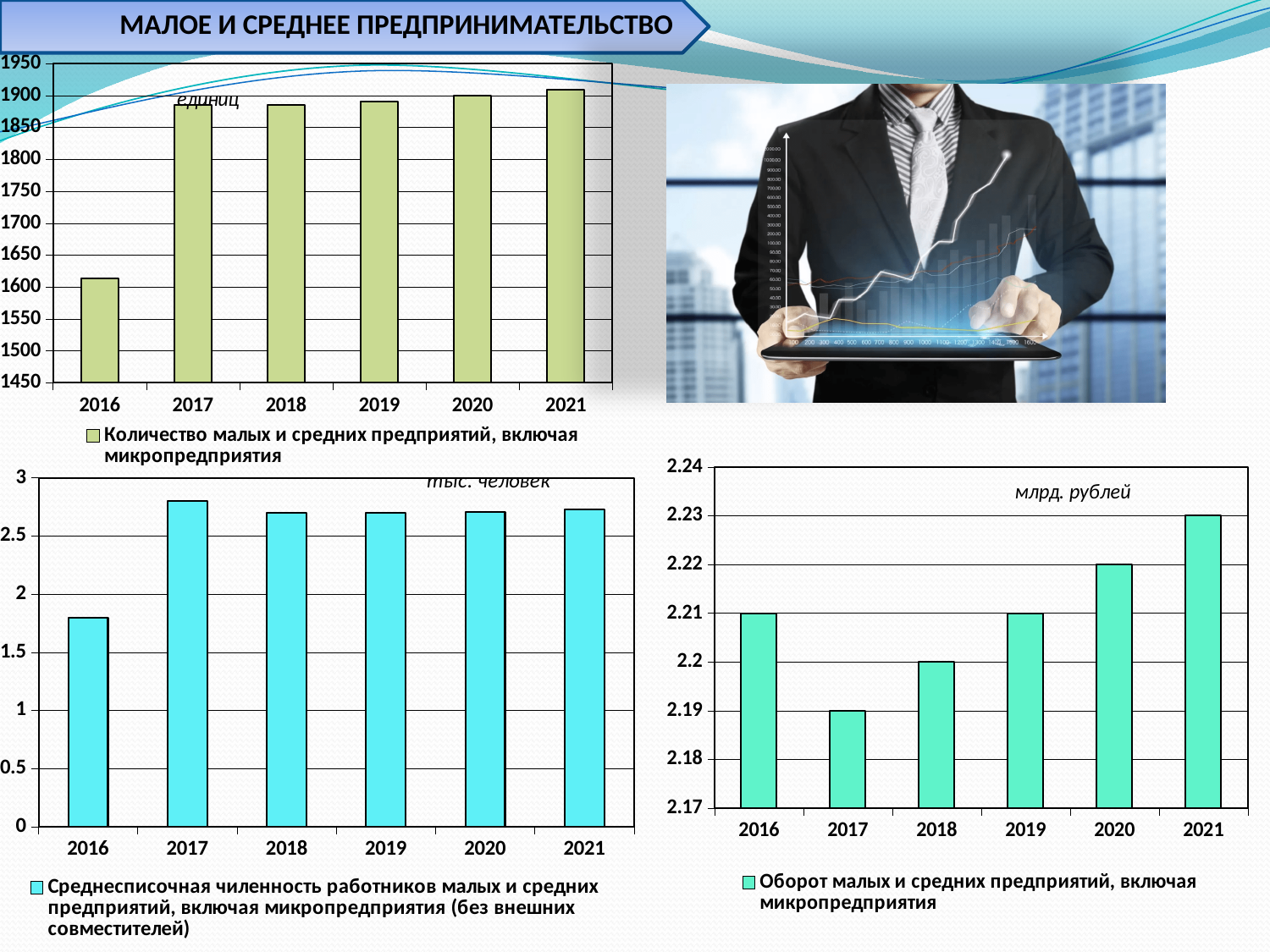
On the bottom-right chart (Оборот малых и средних предприятий), which year has the highest value? 2021 How many years are shown on the bottom-right chart (Оборот малых и средних предприятий)? 6 On the bottom-left chart (Среднесписочная численность работников), is the value for 2016 greater or less than 2? less On the top-left chart (Количество малых и средних предприятий), which year has the lowest value? 2016 On the bottom-right chart (Оборот малых и средних предприятий), what is the value for 2021? 2.23 On the bottom-right chart (Оборот малых и средних предприятий), which year has the lowest value? 2017 On the top-left chart (Количество малых и средних предприятий), is the value for 2016 greater or less than 1650? less On the top-left chart (Количество малых и средних предприятий), which is larger, the value for 2016 or the value for 2017? 2017 On the bottom-right chart (Оборот малых и средних предприятий), what is the value for 2017? 2.19 On the bottom-left chart (Среднесписочная численность работников), which year has the highest value? 2017 What unit is shown on the bottom-right chart (Оборот малых и средних предприятий)? млрд. рублей On the bottom-right chart (Оборот малых и средних предприятий), what is the difference between the 2021 value and the 2017 value? 0.04